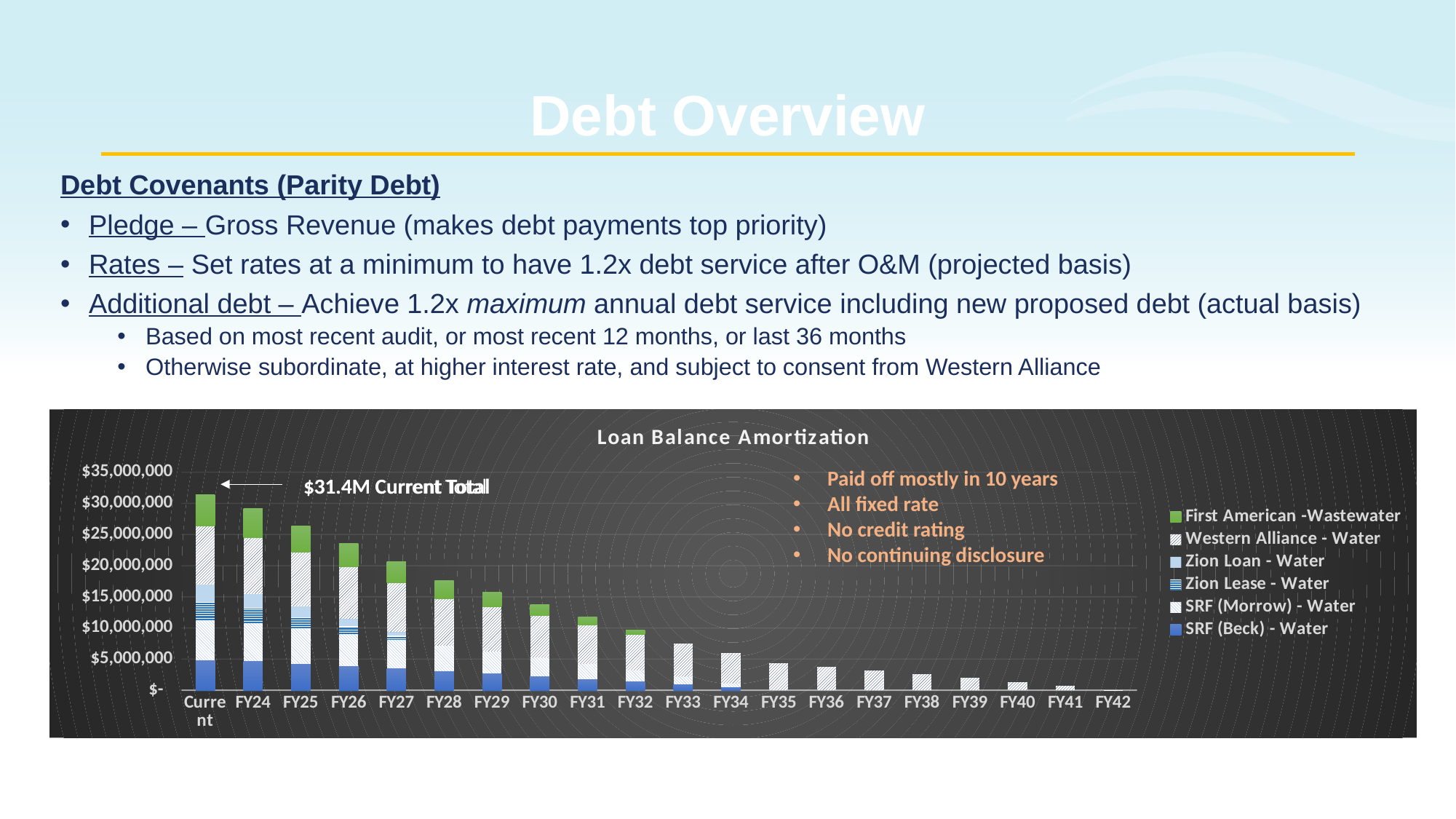
How many categories are shown along the x axis of the chart? 20 Do the total loan balances rise or fall from Current to FY42? Fall Which category has the highest total loan balance? Current Is the total loan balance for FY24 greater or less than $30,000,000? less How many series does the chart's legend list? 6 Is the total loan balance for FY33 greater or less than $10,000,000? less What kind of chart is shown on the slide? Stacked bar chart Which category has the lowest total loan balance? FY42 Which has the larger total loan balance, FY25 or FY30? FY25 What total is annotated for the Current bar? $31.4M Which series is shown in green in the legend? First American -Wastewater What is the title of the chart? Loan Balance Amortization